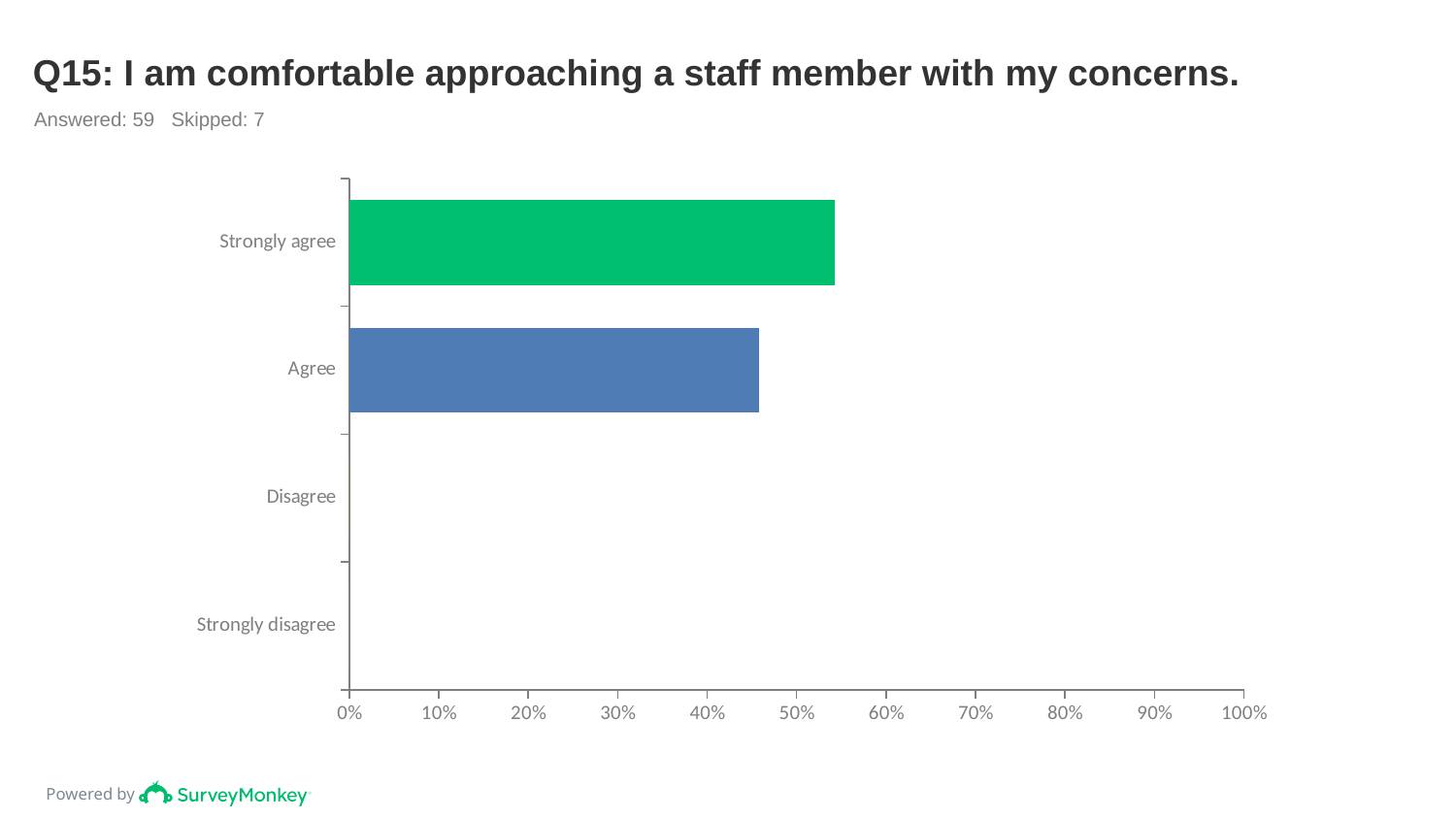
How many respondents answered this question according to the slide? 59 Is the value for Strongly agree greater or less than 50%? greater What is the title of the chart? Q15: I am comfortable approaching a staff member with my concerns. Which response category has the highest value? Strongly agree Which response categories show no bar at all? Disagree and Strongly disagree How many response categories are shown on the chart? 4 Is the value for Agree greater or less than 40%? greater Is the value for Strongly agree greater or less than 60%? less What kind of chart is shown on the slide? Bar chart What is the maximum value shown on the horizontal axis? 100% Which is larger, the value for Strongly agree or the value for Agree? Strongly agree